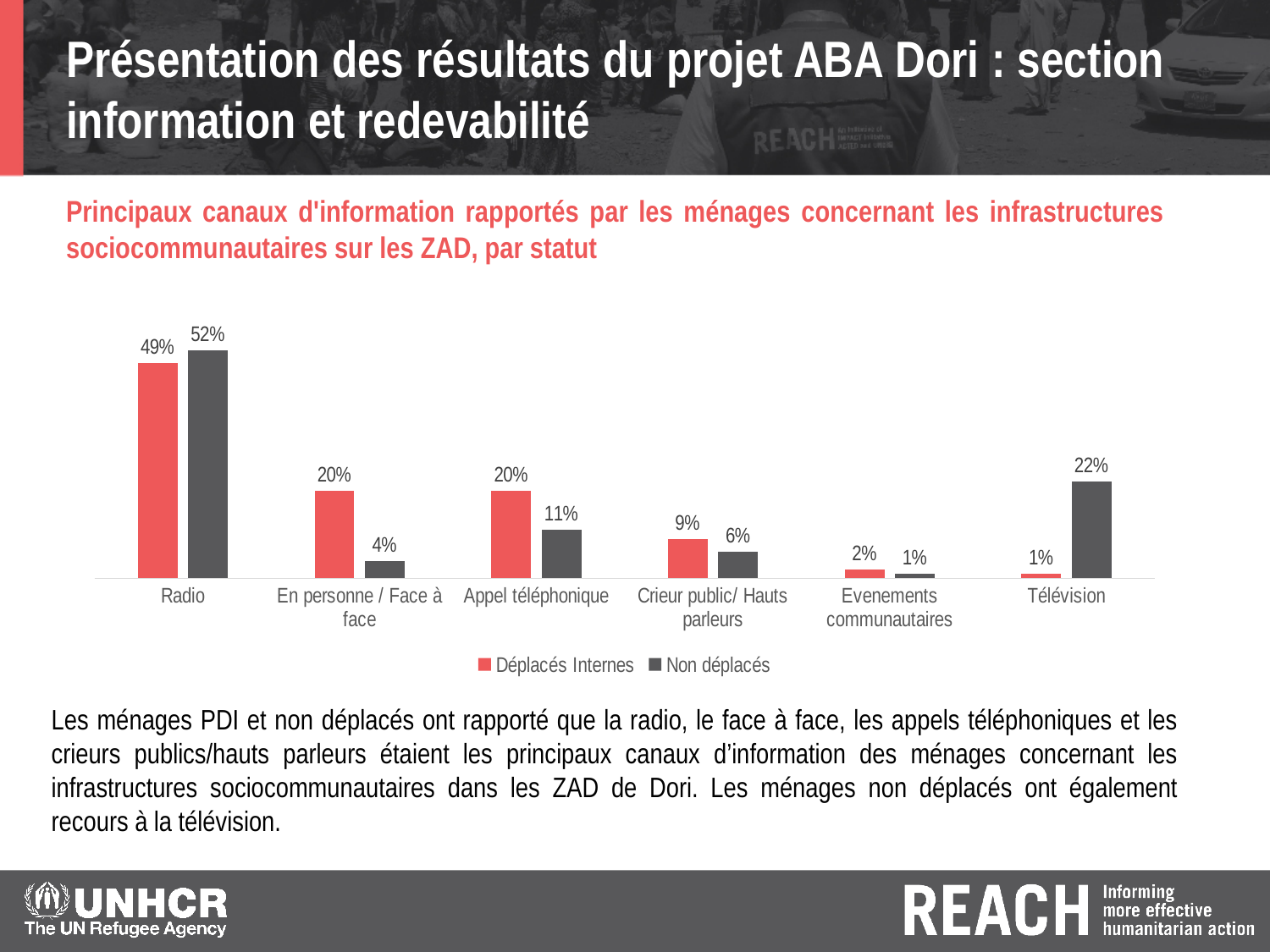
Which colour represents the Non déplacés series? Dark grey How many categories are shown on the x axis? 6 What is the value for Radio in the Déplacés Internes series? 49% How many series does the legend list? 2 What is the value for Télévision in the Non déplacés series? 22% Which category has the highest value in the Non déplacés series? Radio What is the difference between the Non déplacés and Déplacés Internes values for Radio? 3% Which is larger for Crieur public/ Hauts parleurs: the Déplacés Internes value or the Non déplacés value? Déplacés Internes What is the value for En personne / Face à face in the Non déplacés series? 4% Which category has the lowest value in the Déplacés Internes series? Télévision What kind of chart is shown on the slide? Bar chart What is the difference between the Déplacés Internes and Non déplacés values for Appel téléphonique? 9%